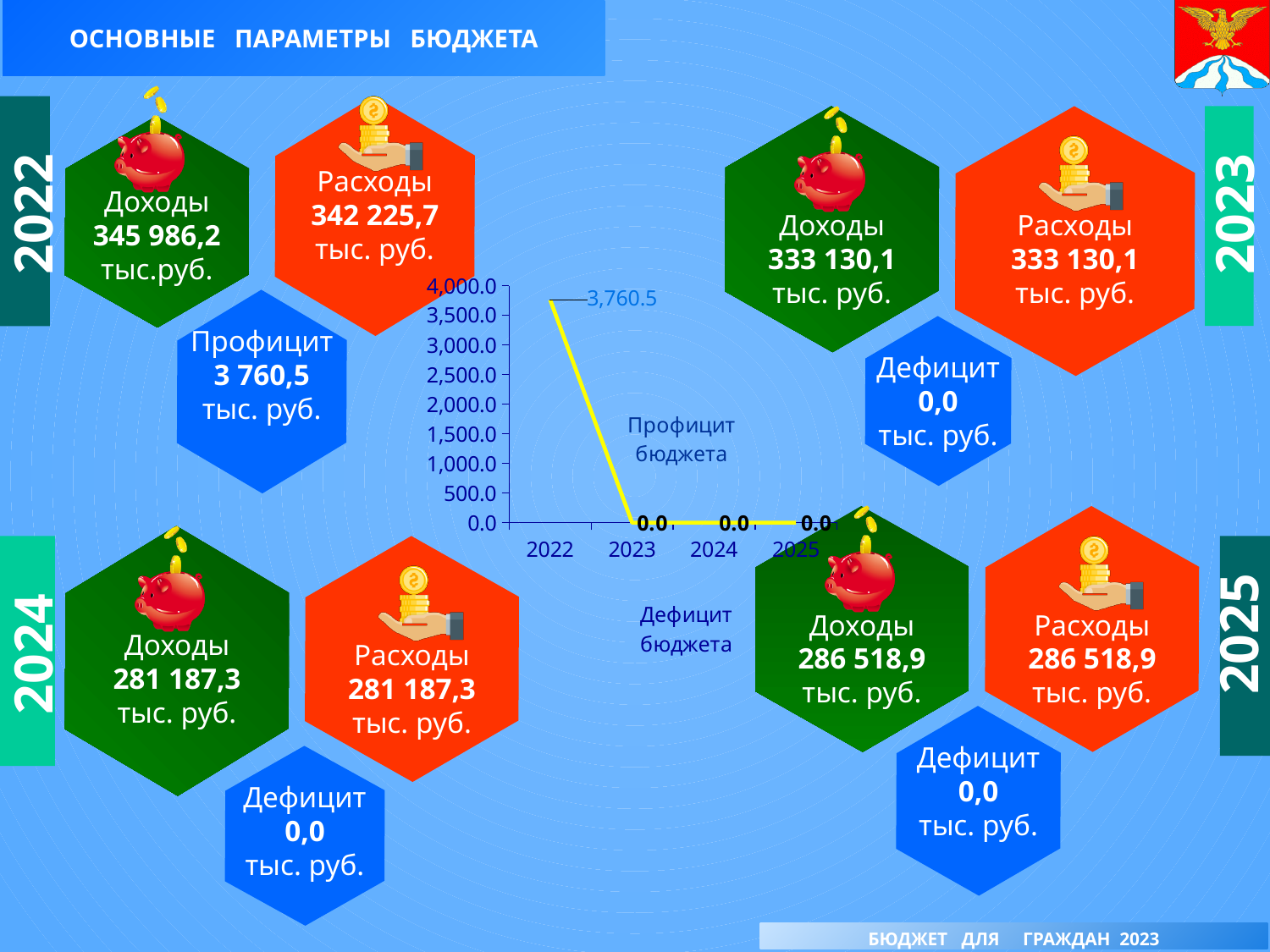
What colour is the line on the chart? yellow What is the maximum value shown on the y axis of the line chart? 4,000.0 Is the value for 2022 on the line chart greater or less than 3,500.0? greater How many years are plotted on the x axis of the line chart? 4 What is the difference between the 2022 value and the 2023 value on the line chart? 3,760.5 Which is larger on the line chart, the value for 2022 or the value for 2024? 2022 What type of chart is shown in the centre of the slide? line chart Does the line on the chart rise or fall from 2022 to 2023? fall What value does the line chart show for 2023? 0.0 What value does the line chart show for 2025? 0.0 Which year has the highest value on the line chart? 2022 What value does the line chart show for 2022? 3,760.5